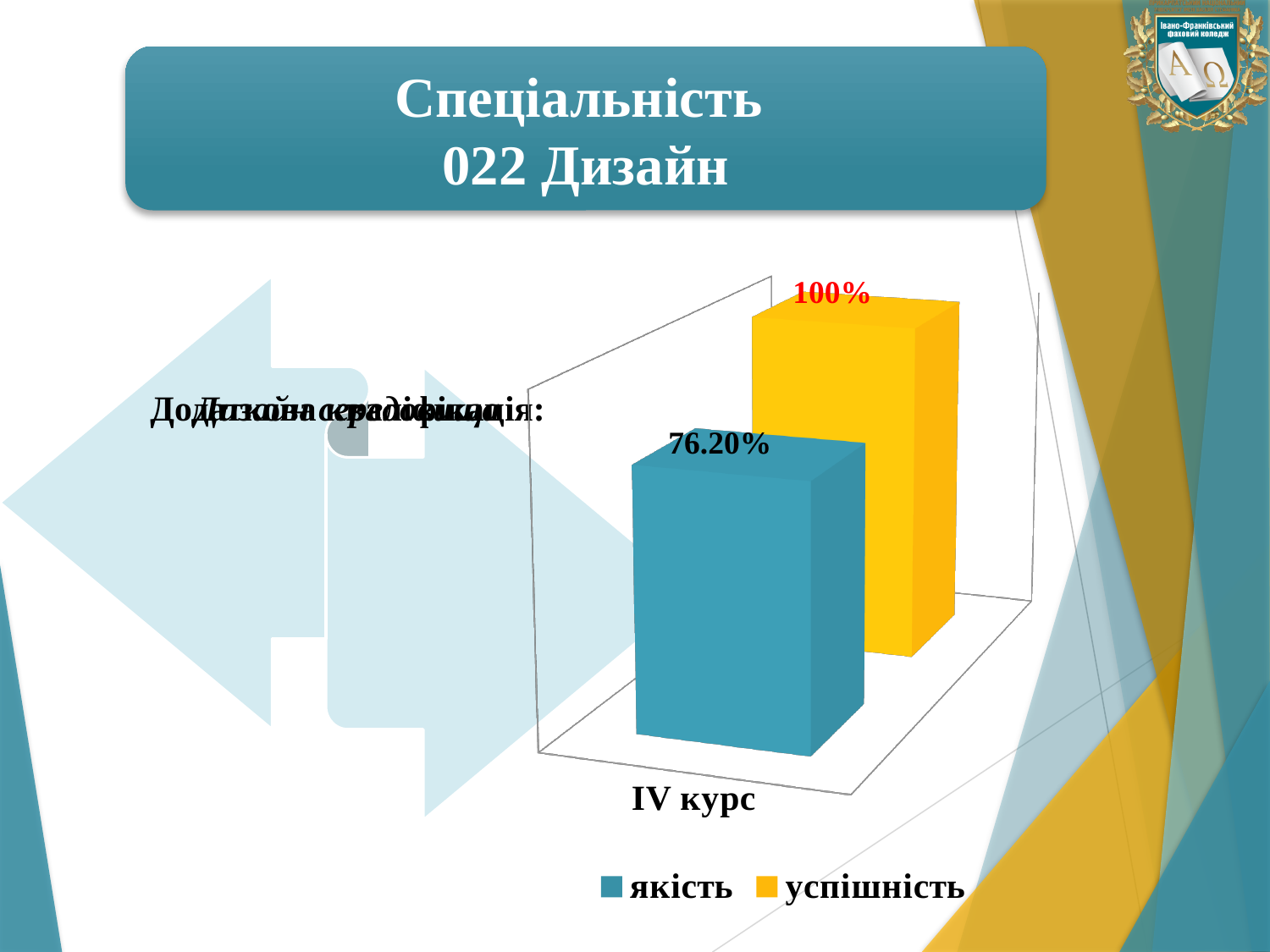
Which series has the lowest value on the chart? якість What is the value for успішність for IV курс? 100% What colour is the bar for успішність? yellow What is the category label shown on the x axis? IV курс Which series has the highest value on the chart? успішність What kind of chart is shown on the slide? bar chart What is the value for якість for IV курс? 76.20% Which series has the higher value for IV курс, якість or успішність? успішність How many categories are shown on the x axis? 1 How many series does the legend list? 2 What is the difference between the успішність and якість values for IV курс? 23.80%